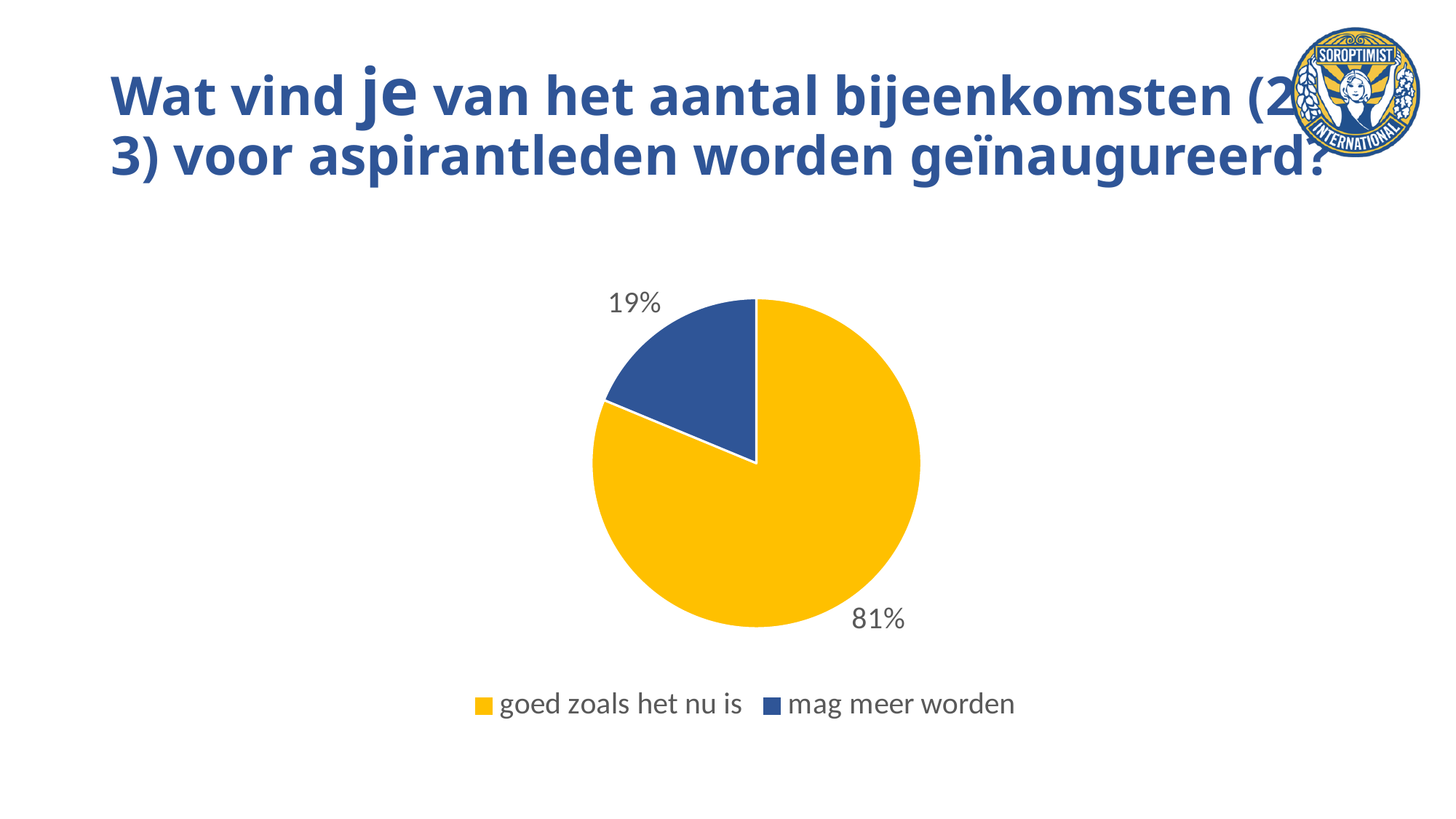
How many slices does the pie chart have? 2 Which category has the largest slice of the pie? goed zoals het nu is What colour is the slice for 'goed zoals het nu is'? yellow How many entries does the legend list? 2 Which is larger: 'goed zoals het nu is' or 'mag meer worden'? goed zoals het nu is What colour is the slice for 'mag meer worden'? blue What share of the pie is 'goed zoals het nu is'? 81% Which category has the smallest slice of the pie? mag meer worden What is the difference in percentage points between 'goed zoals het nu is' and 'mag meer worden'? 62 What kind of chart is shown on the slide? pie chart What share of the pie is 'mag meer worden'? 19%